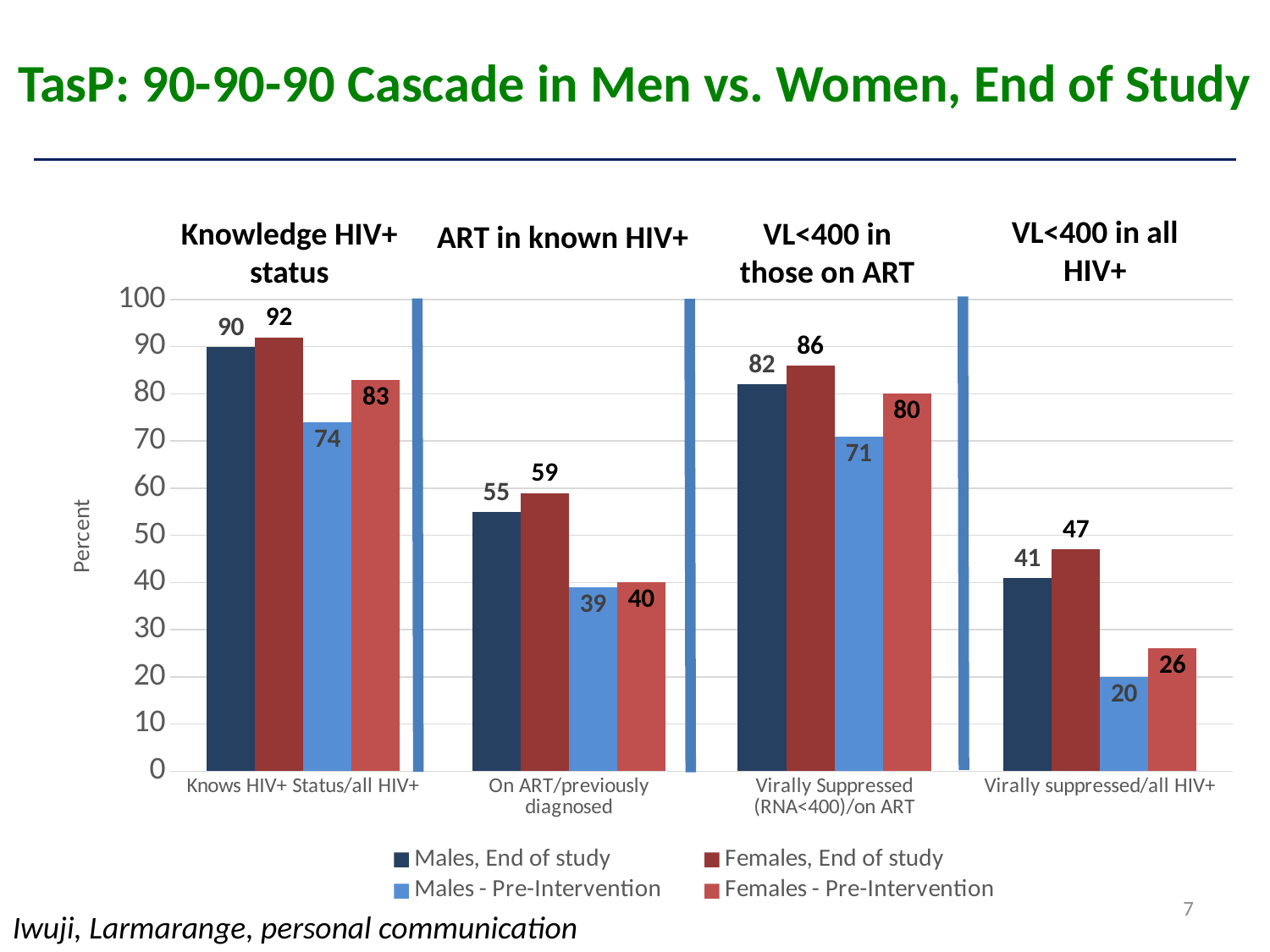
What is the value for Males - Pre-Intervention in the Virally Suppressed (RNA<400)/on ART category? 71 Which is larger in the Knows HIV+ Status/all HIV+ category: Males - Pre-Intervention or Females - Pre-Intervention? Females - Pre-Intervention What is the difference between Females, End of study and Males, End of study in the Virally suppressed/all HIV+ category? 6 What is the value for Females - Pre-Intervention in the On ART/previously diagnosed category? 40 What is the difference between Females, End of study and Females - Pre-Intervention in the On ART/previously diagnosed category? 19 What is the value for Males, End of study in the Knows HIV+ Status/all HIV+ category? 90 Which category has the highest value for Females, End of study? Knows HIV+ Status/all HIV+ What kind of chart is shown on the slide? Bar chart How many categories are shown on the x axis? 4 What is the label of the y axis? Percent How many series does the legend list? 4 Which category has the lowest value for Males - Pre-Intervention? Virally suppressed/all HIV+